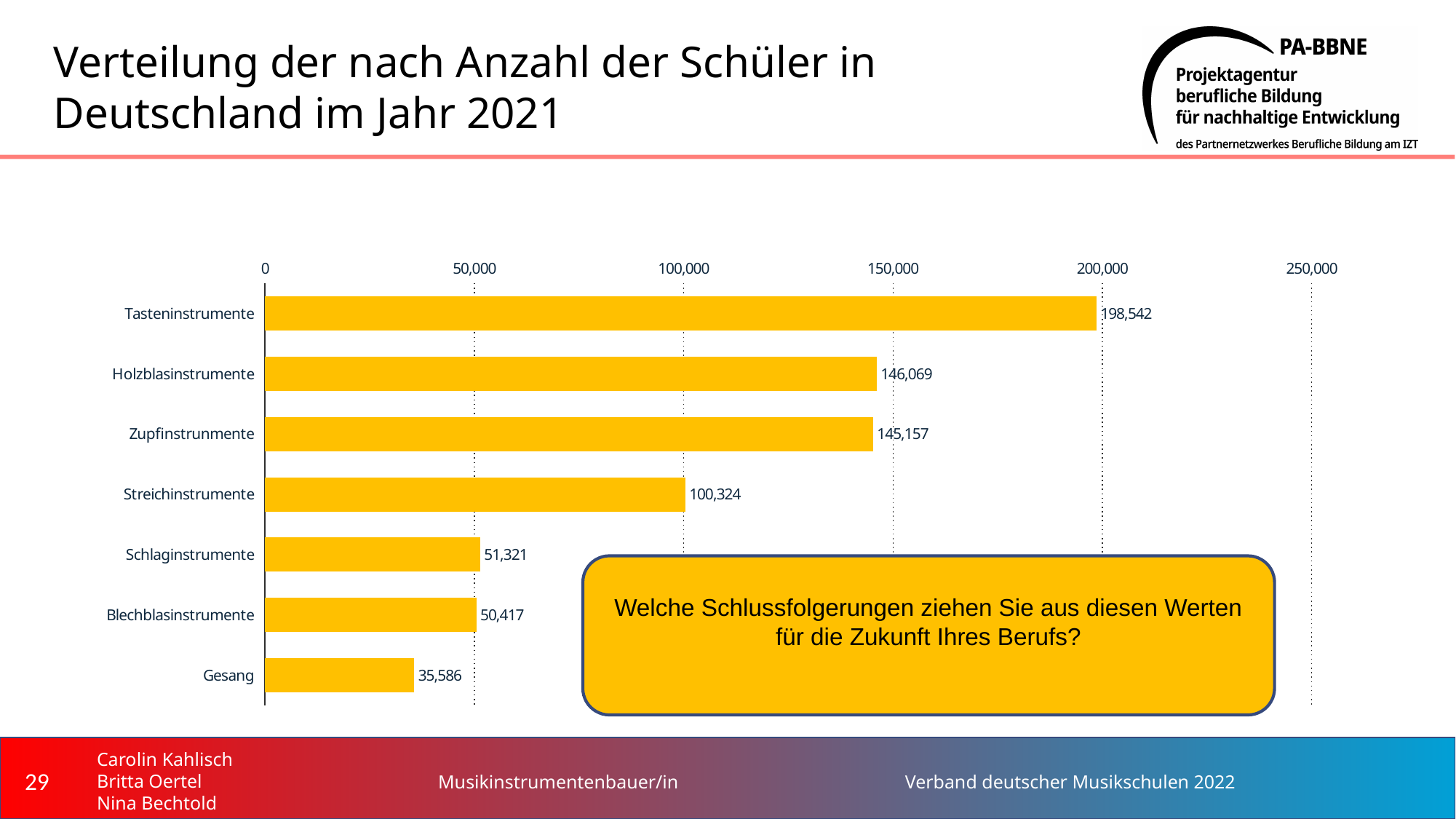
What kind of chart is shown on the slide? bar chart What is the value for Tasteninstrumente? 198,542 What is the difference between the values for Schlaginstrumente and Blechblasinstrumente? 904 What colour are the bars in the chart? yellow Which category has the highest value? Tasteninstrumente How many categories are shown in the chart? 7 Which is larger, the value for Streichinstrumente or the value for Schlaginstrumente? Streichinstrumente What is the value for Gesang? 35,586 What is the difference between the values for Tasteninstrumente and Holzblasinstrumente? 52,473 Which category has the lowest value? Gesang What is the value for Streichinstrumente? 100,324 Is the value for Zupfinstrunmente greater or less than 150,000? less